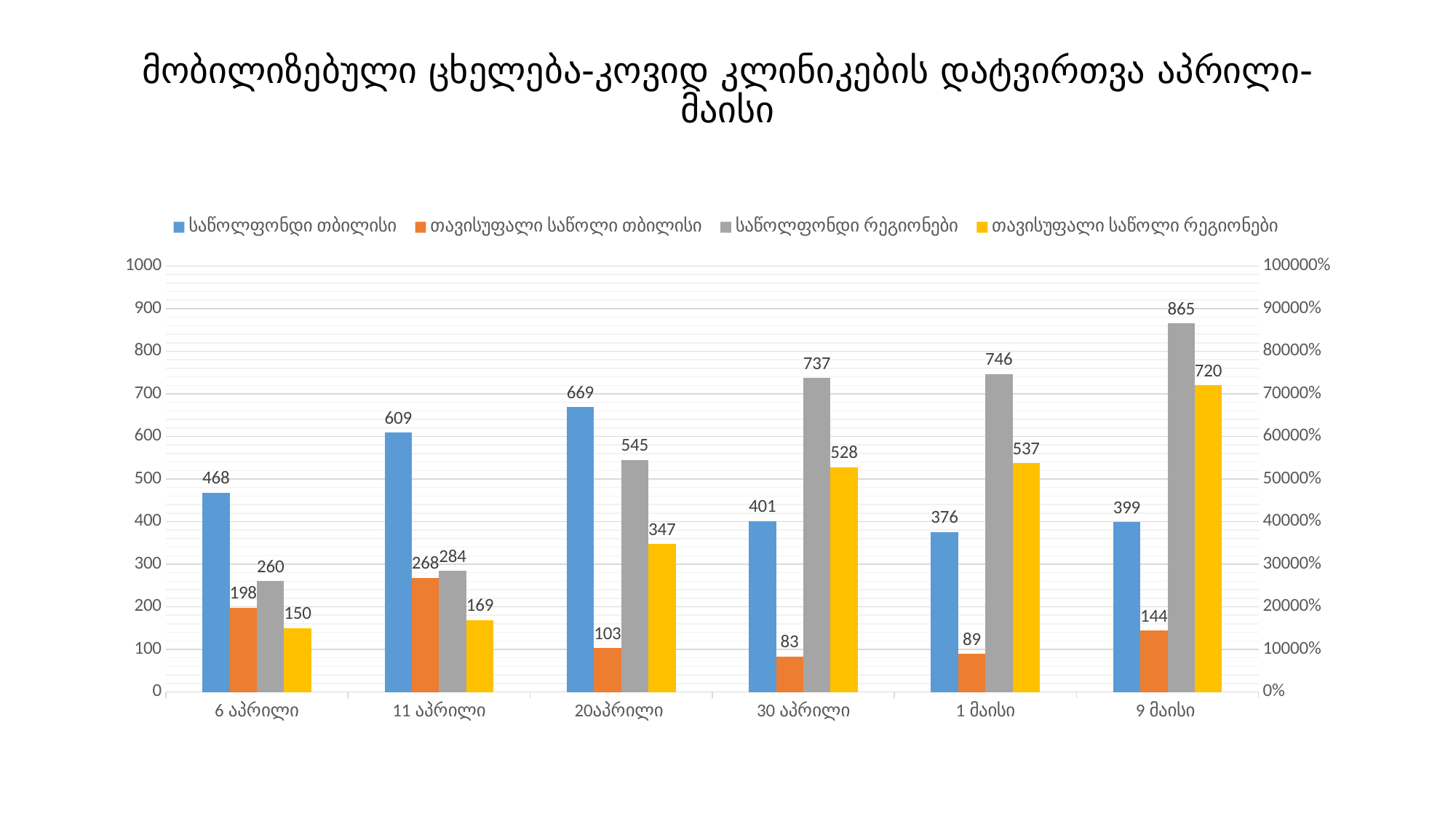
Does საწოლფონდი რეგიონები rise or fall from 6 აპრილი to 9 მაისი? rise Is the value of საწოლფონდი რეგიონები on 30 აპრილი greater or less than 700? greater On which date is საწოლფონდი რეგიონები highest? 9 მაისი Which is larger on 11 აპრილი: საწოლფონდი თბილისი or საწოლფონდი რეგიონები? საწოლფონდი თბილისი On which date is საწოლფონდი თბილისი lowest? 1 მაისი What is the value of საწოლფონდი თბილისი on 6 აპრილი? 468 What is the value of თავისუფალი საწოლი თბილისი on 30 აპრილი? 83 How many dates are shown on the x axis? 6 How many series does the legend list? 4 What is the value of თავისუფალი საწოლი რეგიონები on 9 მაისი? 720 What is the difference between საწოლფონდი რეგიონები and საწოლფონდი თბილისი on 9 მაისი? 466 What kind of chart is shown on the slide? bar chart